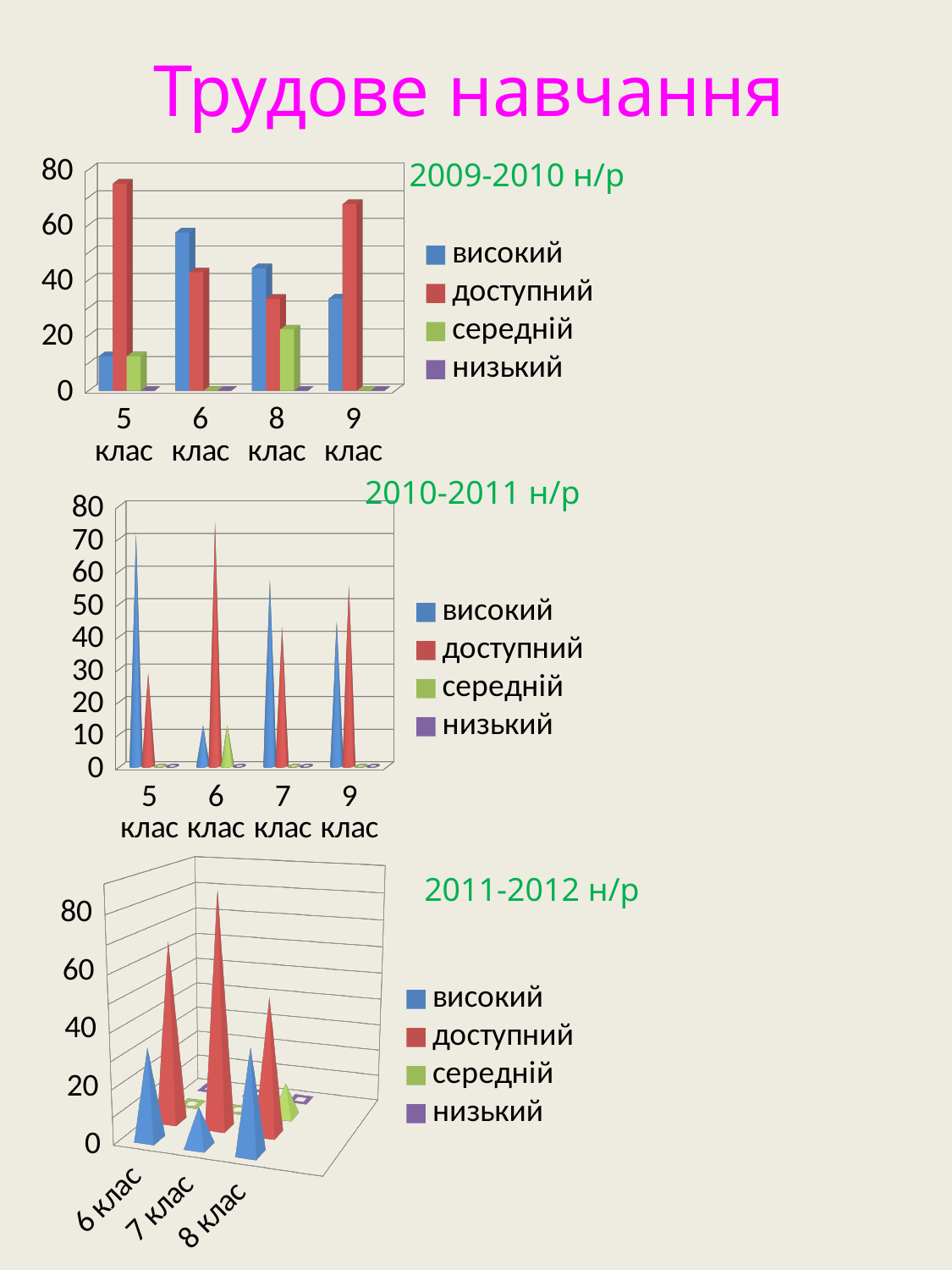
How many classes are shown on the x axis of the 2010-2011 н/р chart? 4 How many classes are shown on the x axis of the 2009-2010 н/р chart? 4 What is the title of the slide above the three charts? Трудове навчання In the 2010-2011 н/р chart, is the value of високий for 5 клас greater or less than 60? greater In the 2009-2010 н/р chart, is the value of доступний for 5 клас greater or less than 60? greater What kind of chart is the 2009-2010 н/р chart? bar chart In the 2009-2010 н/р chart, for 6 клас, which is larger: високий or доступний? високий In the 2009-2010 н/р chart, which class has the highest value for високий? 6 клас In the 2010-2011 н/р chart, which class has the highest value for доступний? 6 клас In the 2011-2012 н/р chart, which class has the highest value for доступний? 7 клас How many series does the legend of the 2009-2010 н/р chart list? 4 How many classes are shown on the x axis of the 2011-2012 н/р chart? 3